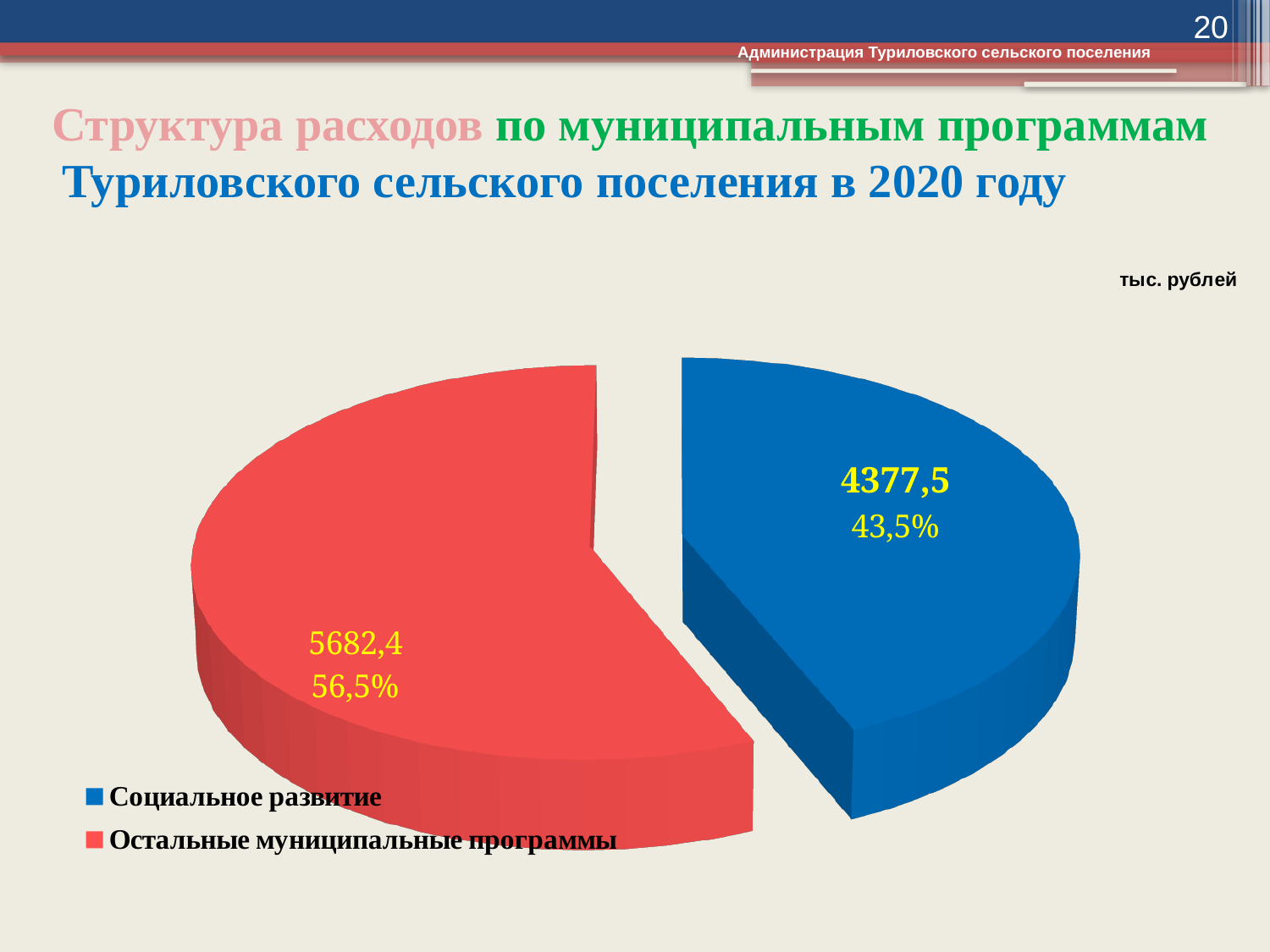
What is the value for Социальное развитие? 4377,5 Which category has the smallest slice? Социальное развитие What colour is the slice for Социальное развитие? blue What kind of chart is shown on the slide? pie chart Which category has the largest slice? Остальные муниципальные программы What is the difference between the values for Остальные муниципальные программы and Социальное развитие? 1304,9 How many entries does the legend list? 2 How many slices does the pie chart have? 2 What share of the pie does Остальные муниципальные программы take? 56,5% What share of the pie does Социальное развитие take? 43,5% Which is larger: Социальное развитие or Остальные муниципальные программы? Остальные муниципальные программы What is the value for Остальные муниципальные программы? 5682,4